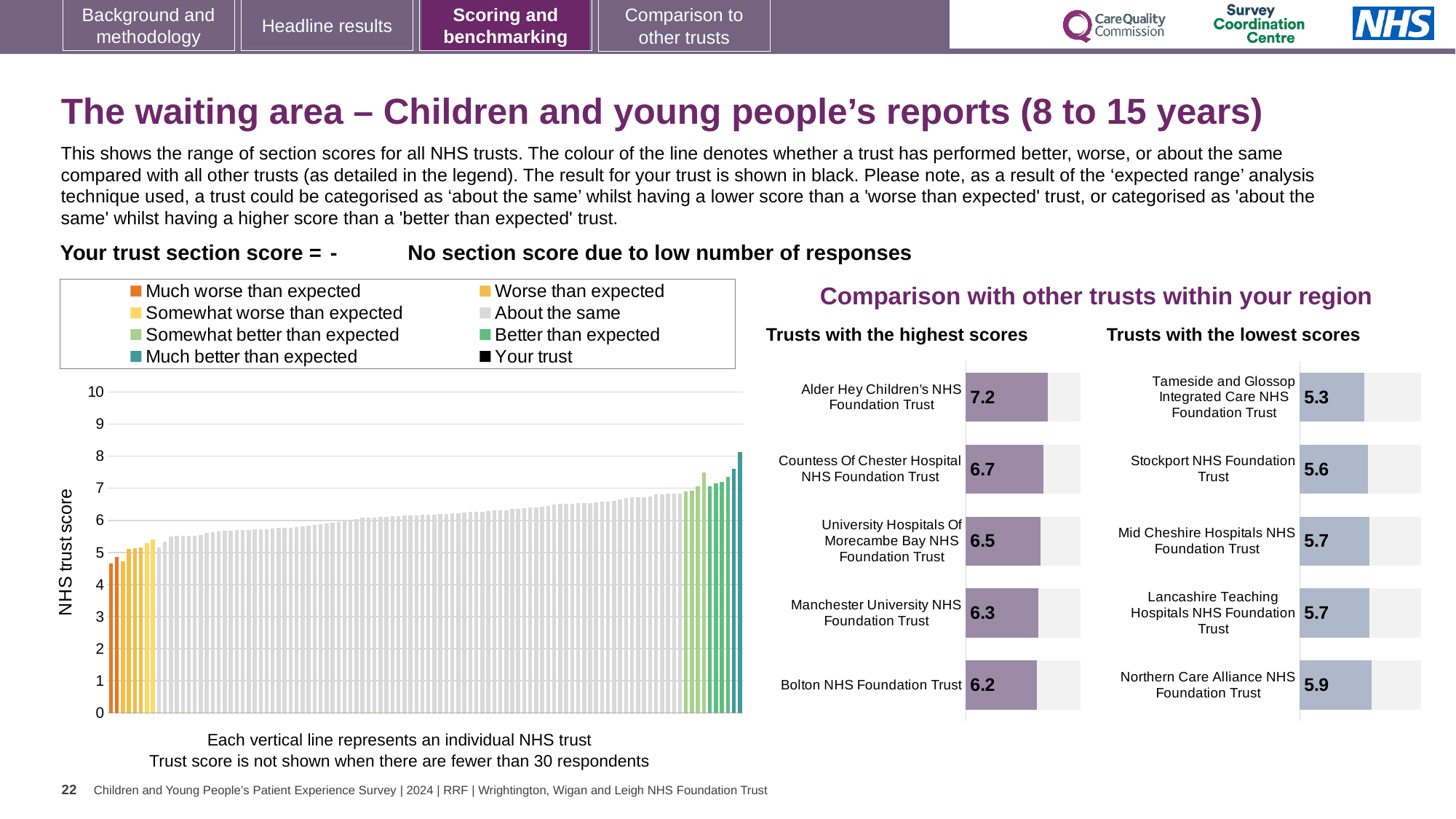
In the 'Trusts with the highest scores' chart, what is the score for Alder Hey Children's NHS Foundation Trust? 7.2 How many trusts are shown in the 'Trusts with the highest scores' chart? 5 How many entries does the legend above the large chart on the left list? 8 In the 'Trusts with the lowest scores' chart, what is the score for Northern Care Alliance NHS Foundation Trust? 5.9 In the 'Trusts with the lowest scores' chart, which trust has the lowest score? Tameside and Glossop Integrated Care NHS Foundation Trust In the 'Trusts with the highest scores' chart, what is the score for Bolton NHS Foundation Trust? 6.2 In the 'Trusts with the highest scores' chart, what is the difference between the scores of Alder Hey Children's NHS Foundation Trust and Countess Of Chester Hospital NHS Foundation Trust? 0.5 In the 'Trusts with the lowest scores' chart, what is the score for Tameside and Glossop Integrated Care NHS Foundation Trust? 5.3 In the 'Trusts with the highest scores' chart, which trust has the highest score? Alder Hey Children's NHS Foundation Trust What type of chart is the large chart on the left showing NHS trust scores? Bar chart In the large chart on the left, do the NHS trust scores rise or fall from left to right? Rise Comparing the regional charts, which has the higher score: Stockport NHS Foundation Trust or Manchester University NHS Foundation Trust? Manchester University NHS Foundation Trust